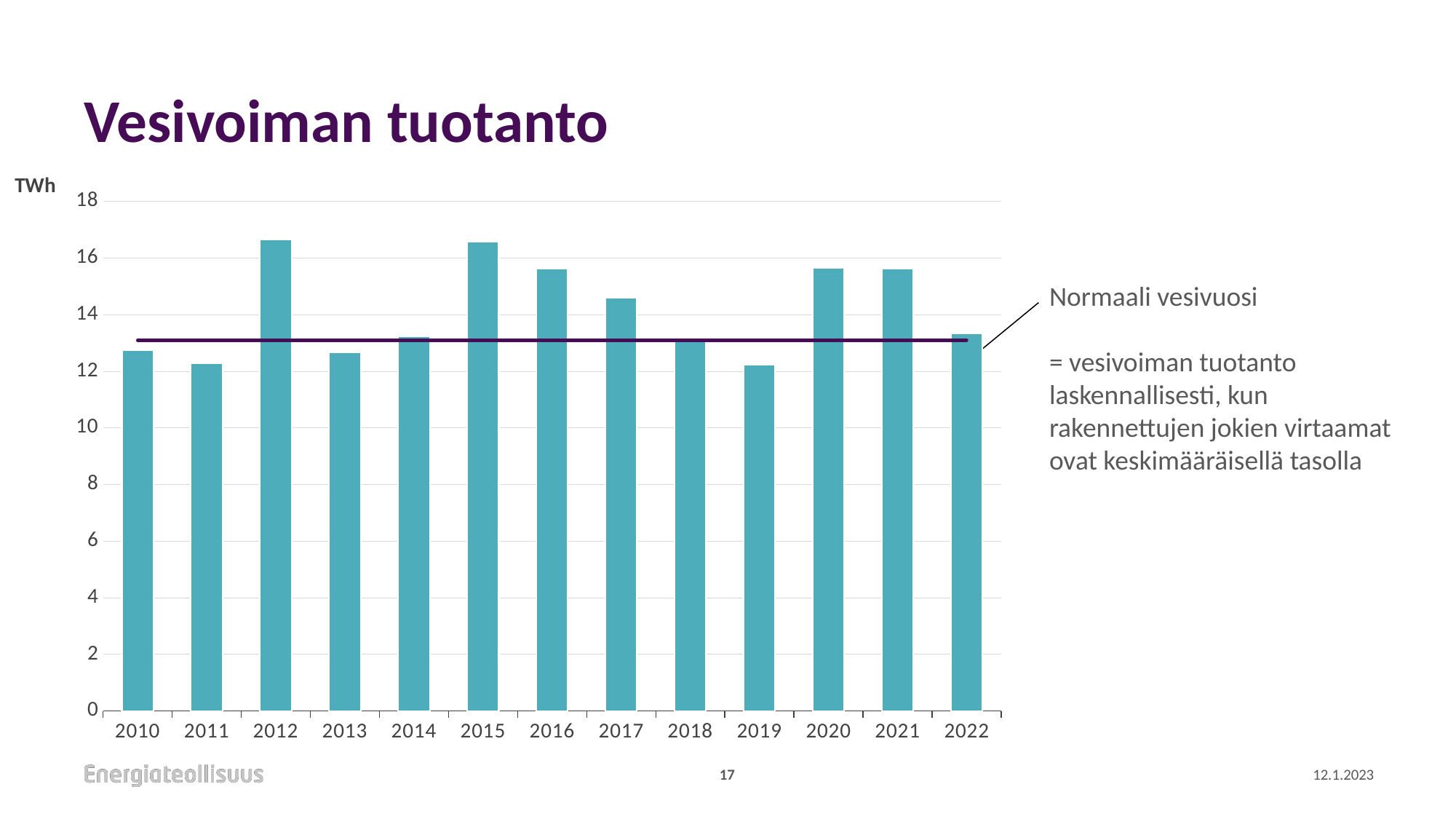
Do the values rise or fall from 2017 to 2019? fall Is the value for 2016 greater or less than 14? greater What kind of chart is shown on the slide? bar chart Which year has the larger value, 2012 or 2013? 2012 How many years are shown on the x axis of the chart? 13 Is the value for 2019 greater or less than 14? less Which year has the larger value, 2017 or 2019? 2017 Is the value for 2012 greater or less than 16? greater What is the title of the chart? Vesivoiman tuotanto What unit is shown on the vertical axis of the chart? TWh